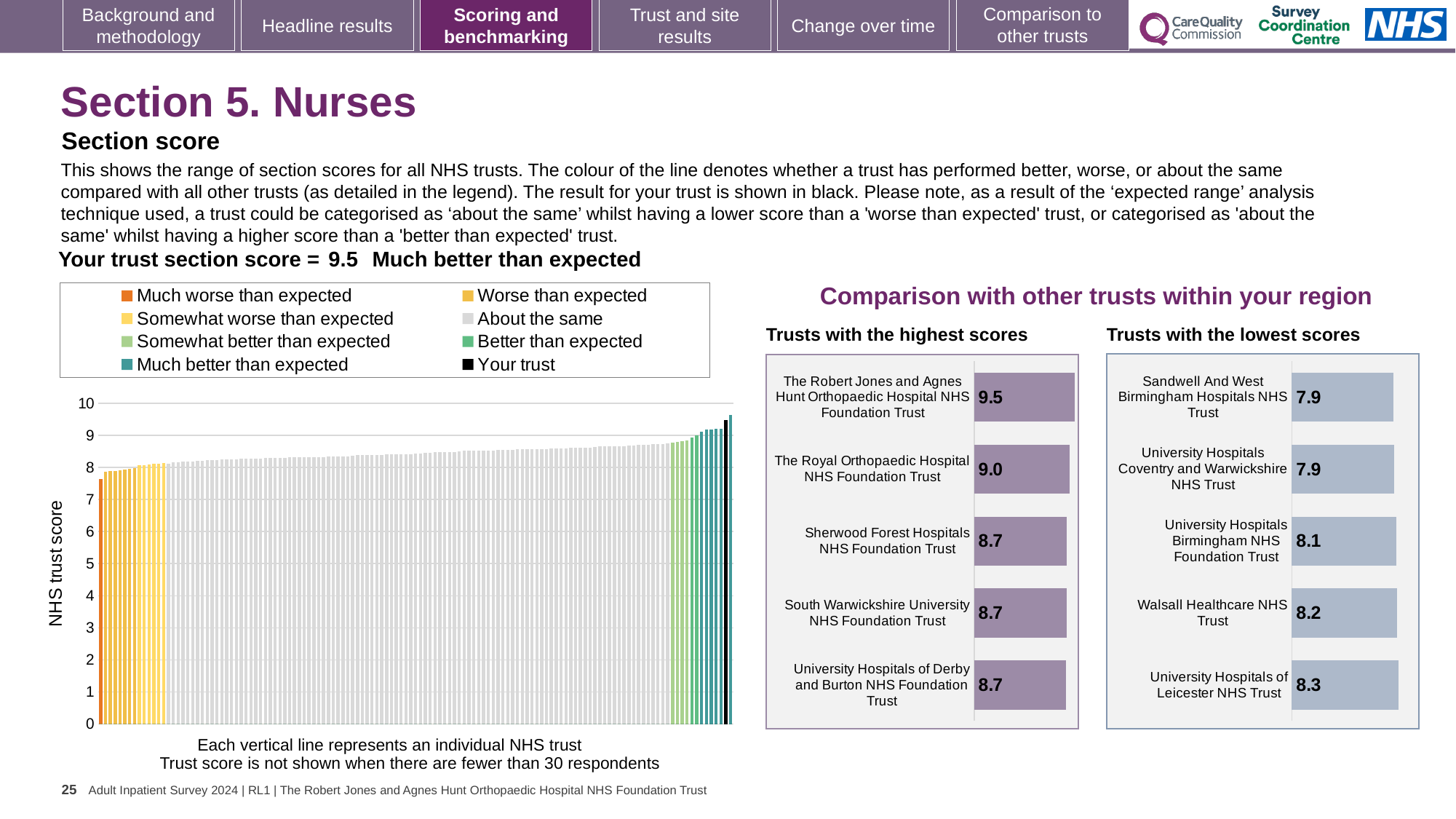
In the 'Trusts with the highest scores' chart, which trust has the highest score? The Robert Jones and Agnes Hunt Orthopaedic Hospital NHS Foundation Trust In the 'Trusts with the lowest scores' chart, what is the score for Walsall Healthcare NHS Trust? 8.2 In the 'Trusts with the highest scores' chart, what is the score for The Royal Orthopaedic Hospital NHS Foundation Trust? 9.0 How many entries does the legend of the large 'NHS trust score' chart list? 8 In the 'Trusts with the lowest scores' chart, what is the difference between the scores of University Hospitals of Leicester NHS Trust and Sandwell And West Birmingham Hospitals NHS Trust? 0.4 What kind of chart is the large 'NHS trust score' chart on the left? Bar chart In the large 'NHS trust score' chart, is the value of the black 'Your trust' bar greater or less than 9? greater In the 'Trusts with the highest scores' chart, what is the difference between the scores of The Robert Jones and Agnes Hunt Orthopaedic Hospital NHS Foundation Trust and The Royal Orthopaedic Hospital NHS Foundation Trust? 0.5 Comparing the two small charts on the right, which has the higher score: Sherwood Forest Hospitals NHS Foundation Trust or Walsall Healthcare NHS Trust? Sherwood Forest Hospitals NHS Foundation Trust In the 'Trusts with the lowest scores' chart, which trust has the highest score shown? University Hospitals of Leicester NHS Trust In the large 'NHS trust score' chart, do the values rise or fall from left to right along the x axis? Rise How many trusts are shown in the 'Trusts with the highest scores' chart? 5